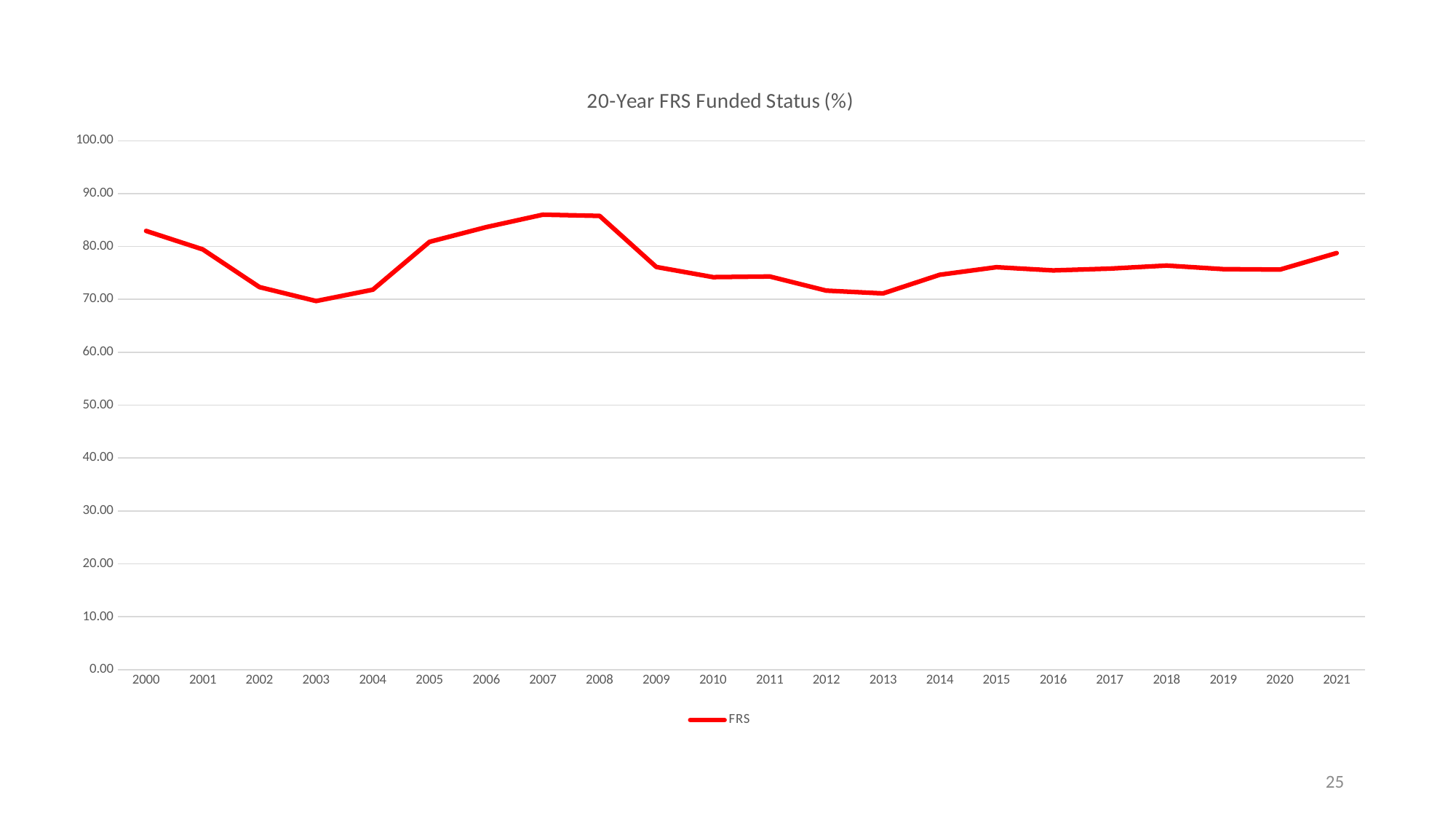
Do the values rise or fall from 2000 to 2003? fall Which is larger, the value for 2007 or the value for 2013? 2007 Is the value for 2009 greater or less than 80? less How many years are plotted along the x axis? 22 How many series does the legend list? 1 Which is larger, the value for 2002 or the value for 2005? 2005 What is the title of the chart? 20-Year FRS Funded Status (%) Is the value for 2000 greater or less than 80? greater Is the value for 2010 greater or less than 70? greater What kind of chart is shown on the slide? Line chart Do the values rise or fall from 2003 to 2007? rise